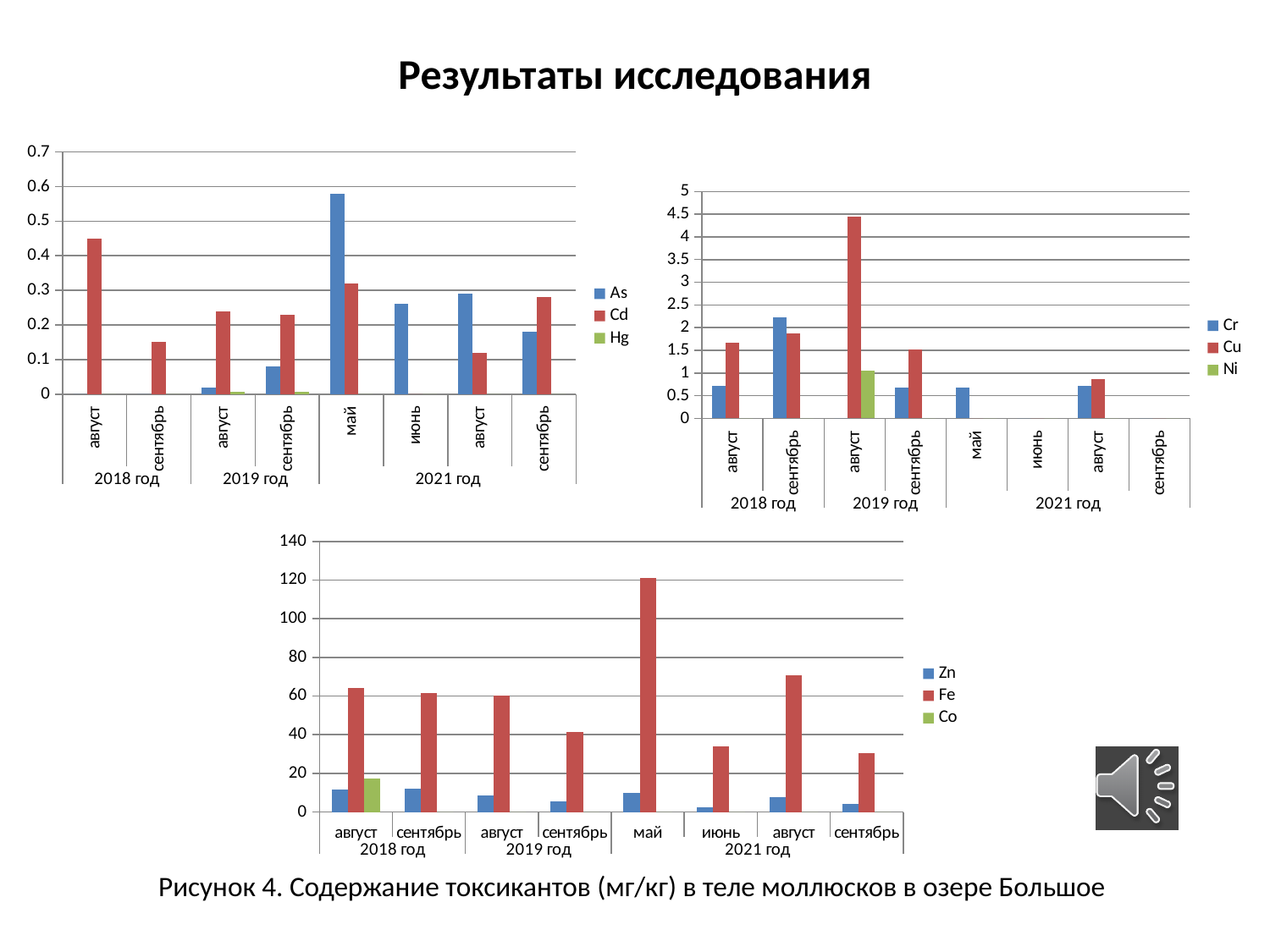
In the bottom chart (Zn, Fe, Co), how many month categories are shown along the x axis? 8 In the bottom chart (Zn, Fe, Co), is the Fe value for сентябрь 2021 год greater or less than 40? less In the top-left chart (As, Cd, Hg), which is larger for май 2021 год, the As value or the Cd value? As In the bottom chart (Zn, Fe, Co), is the Fe value for май 2021 год greater or less than 100? greater In the top-right chart (Cr, Cu, Ni), what are the series listed in the legend? Cr, Cu, Ni In the top-right chart (Cr, Cu, Ni), in which month and year is the Cu value highest? август 2019 год In the bottom chart (Zn, Fe, Co), what kind of chart is shown? bar chart In the bottom chart (Zn, Fe, Co), in which month and year is the Fe value highest? май 2021 год In the top-left chart (As, Cd, Hg), in which month and year is the As value highest? май 2021 год In the top-left chart (As, Cd, Hg), is the Cd value for август 2018 год greater or less than 0.4? greater In the top-left chart (As, Cd, Hg), how many series does the legend list? 3